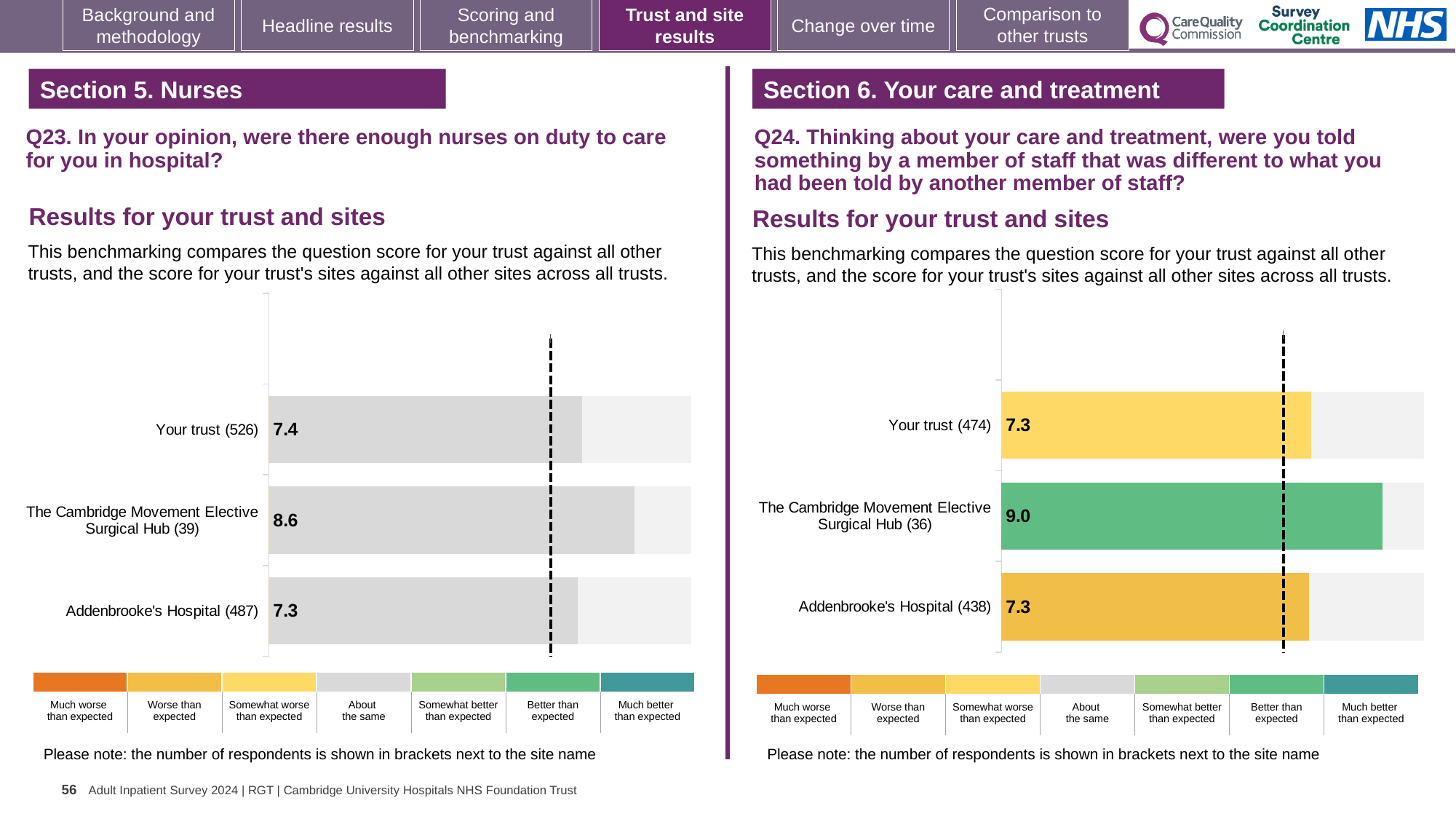
On the Q24 chart (right), which site or trust has the highest score? The Cambridge Movement Elective Surgical Hub (36) On the Q23 chart (left), what is the score for The Cambridge Movement Elective Surgical Hub (39)? 8.6 On the Q24 chart (right), what is the score for The Cambridge Movement Elective Surgical Hub (36)? 9.0 On the Q24 chart (right), what is the score for Addenbrooke's Hospital (438)? 7.3 On the Q23 chart (left), what is the difference between the scores for The Cambridge Movement Elective Surgical Hub and Addenbrooke's Hospital? 1.3 On the Q24 chart (right), what is the difference between the scores for The Cambridge Movement Elective Surgical Hub and Your trust? 1.7 What type of chart is used on the Q24 chart (right)? Bar chart On the Q23 chart (left), what is the score for Your trust (526)? 7.4 On the Q24 chart (right), what is the score for Your trust (474)? 7.3 How many bars are shown on the Q23 chart (left)? 3 On the Q23 chart (left), which site or trust has the highest score? The Cambridge Movement Elective Surgical Hub (39) On the Q23 chart (left), what is the score for Addenbrooke's Hospital (487)? 7.3